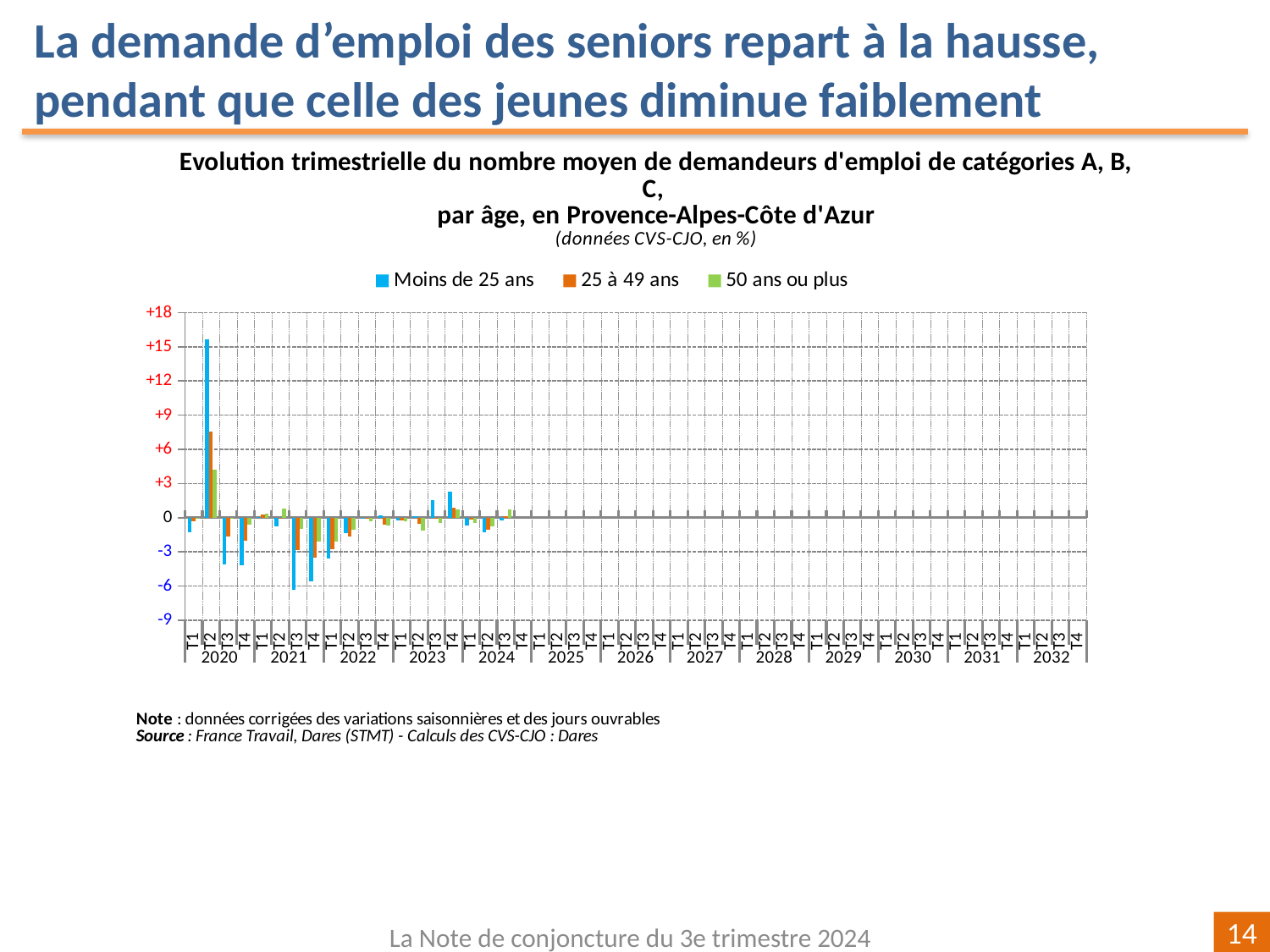
What is the highest value shown on the vertical axis? +18 Is the value for Moins de 25 ans in T3 2021 greater or less than -3? less What kind of chart is shown on the slide? bar chart Is the value for 25 à 49 ans in T2 2020 greater or less than +6? greater Is the value for 50 ans ou plus in T2 2020 greater or less than +3? greater In T2 2020, which is larger: the value for Moins de 25 ans or the value for 25 à 49 ans? Moins de 25 ans Which series has the highest bar in the whole chart? Moins de 25 ans How many series does the legend list? 3 What are the three series named in the legend? Moins de 25 ans, 25 à 49 ans, 50 ans ou plus Which series has the lowest bar in T3 2021? Moins de 25 ans In which quarter does the Moins de 25 ans series reach its highest value? T2 2020